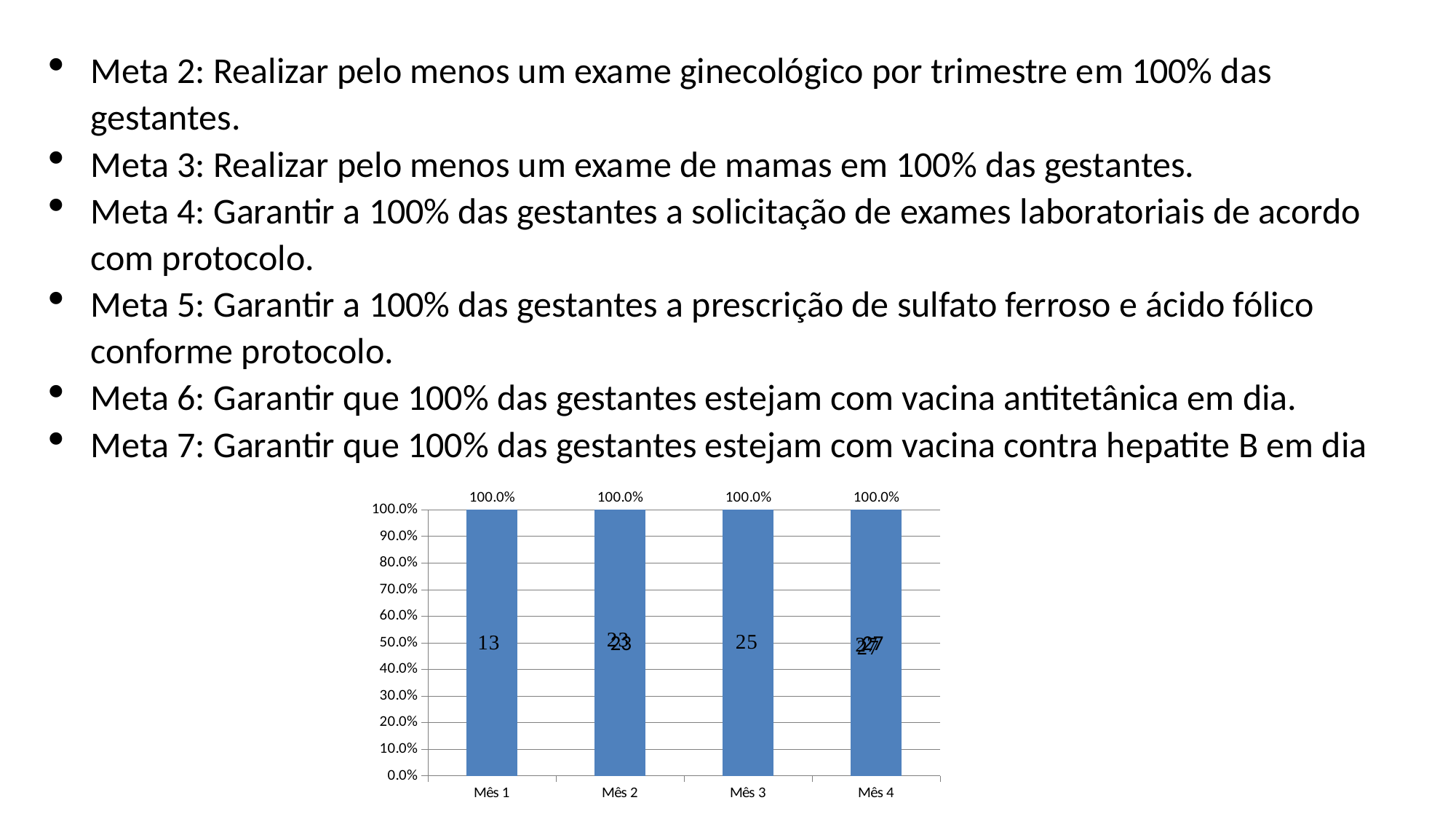
What is the difference between the percentage values for Mês 4 and Mês 1? 0.0% How many categories (months) are shown on the x axis of the chart? 4 What kind of chart is shown on the slide? bar chart What is the label of the first category on the x axis? Mês 1 What is the percentage value shown above the bar for Mês 4? 100.0% What is the percentage value shown above the bar for Mês 3? 100.0% What number is printed inside the bar for Mês 3? 25 What is the percentage value shown above the bar for Mês 1? 100.0% What number is printed inside the bar for Mês 1? 13 What is the highest value shown on the y axis of the chart? 100.0% Do the percentage values rise, fall, or stay the same from Mês 1 to Mês 4? stay the same Is the value for Mês 2 greater or less than 90.0%? greater